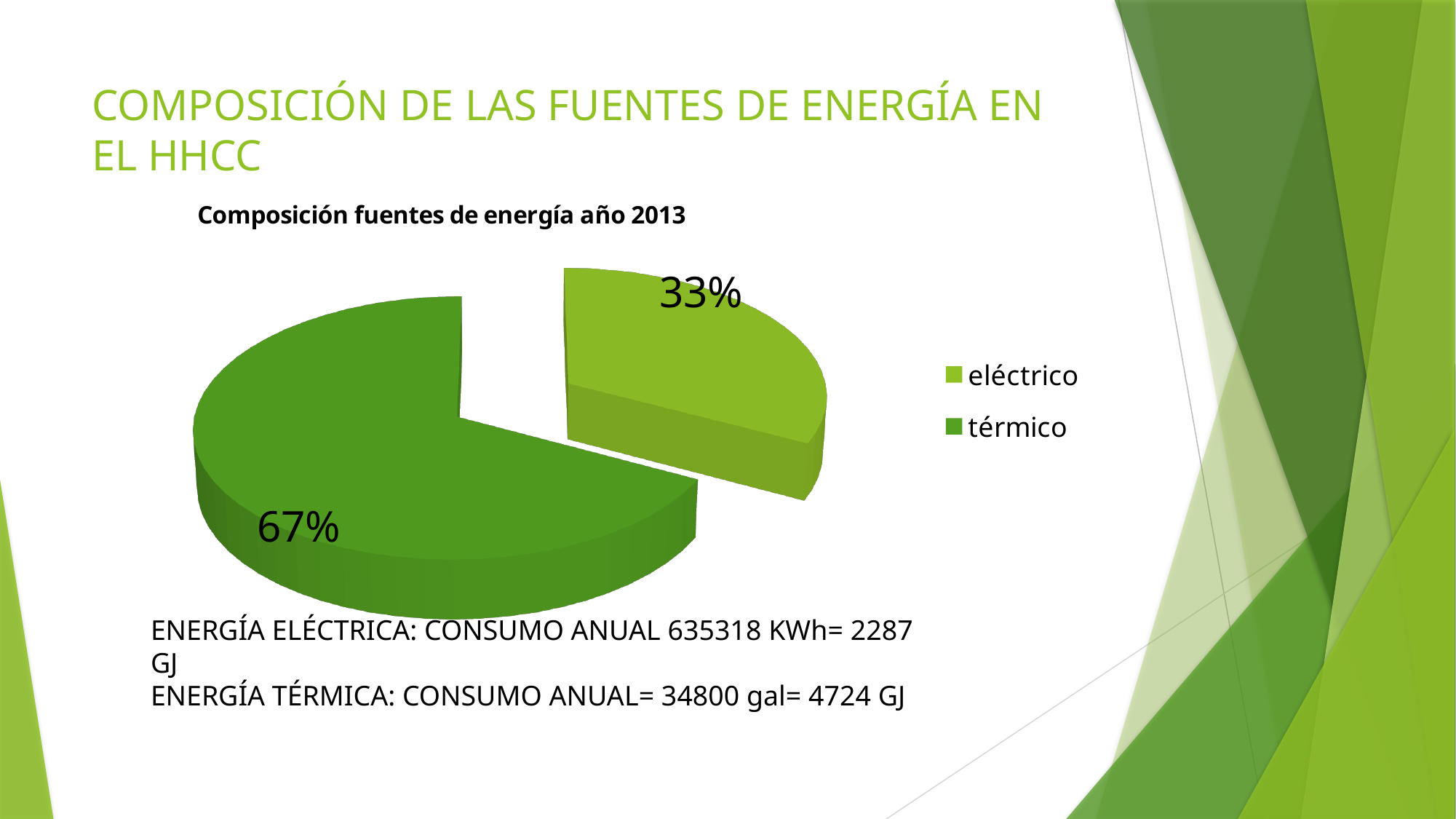
What is the difference in percentage points between the térmico and eléctrico slices? 34 percentage points What share of the pie does the eléctrico slice represent? 33% What is the title of the chart? Composición fuentes de energía año 2013 Which category has the largest slice of the pie? térmico Which category has the smallest slice of the pie? eléctrico What kind of chart is shown on the slide? pie chart Which is larger, the eléctrico slice or the térmico slice? térmico Which legend entry is shown in the darker green colour? térmico How many slices does the pie chart have? 2 How many entries does the legend list? 2 What share of the pie does the térmico slice represent? 67%